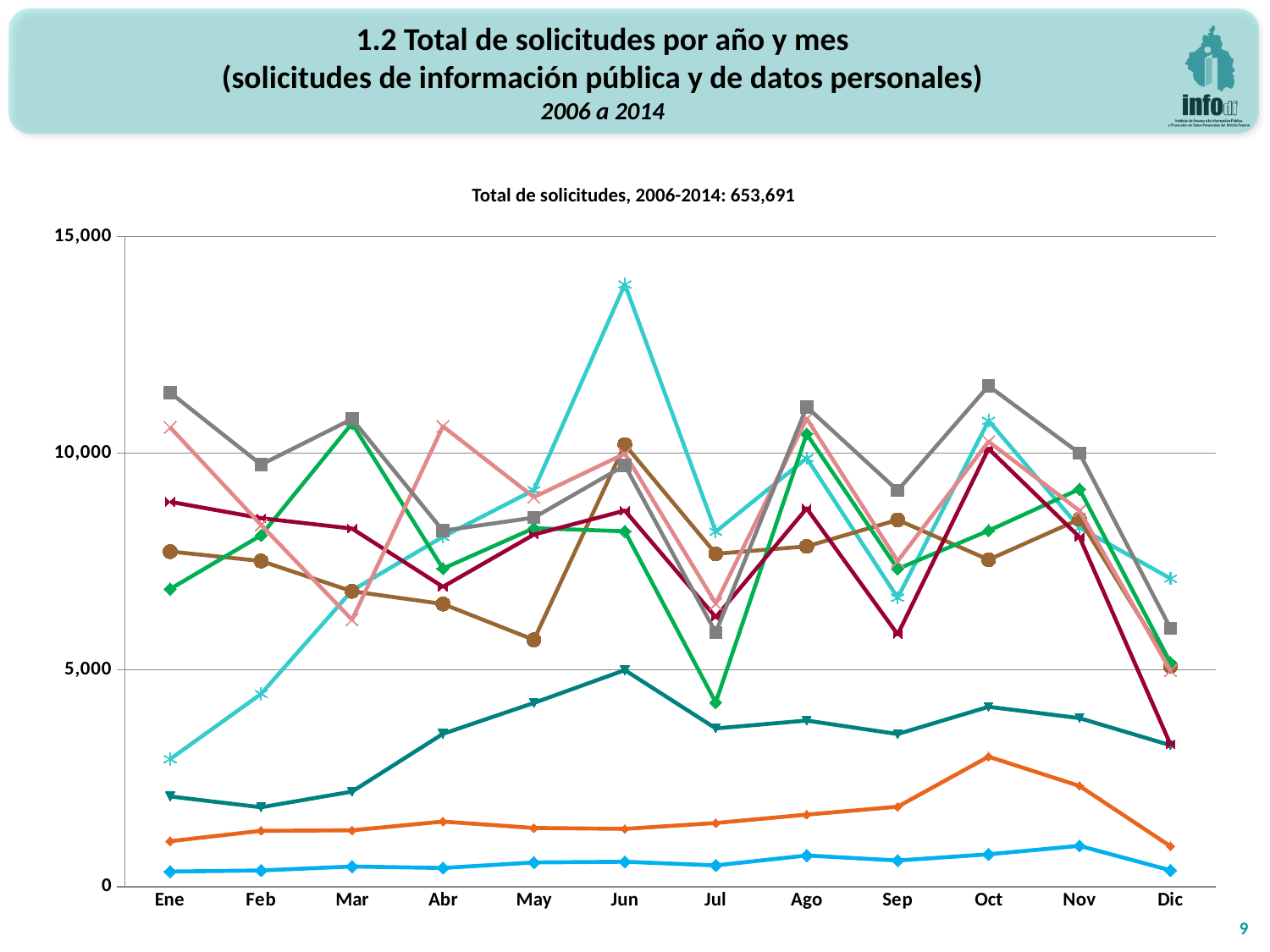
What is the title printed above the chart? Total de solicitudes, 2006-2014: 653,691 What is the highest value shown on the y axis of the chart? 15,000 What total number of solicitudes for 2006-2014 is printed above the chart? 653,691 How many months are shown along the x axis of the chart? 12 In which month does the highest point on the chart occur? Jun Is the lowest point on the chart greater or less than 5,000? less What kind of chart is shown on the slide? line chart What is the first month label on the x axis of the chart? Ene What is the last month label on the x axis of the chart? Dic Is the highest point on the chart greater or less than 10,000? greater